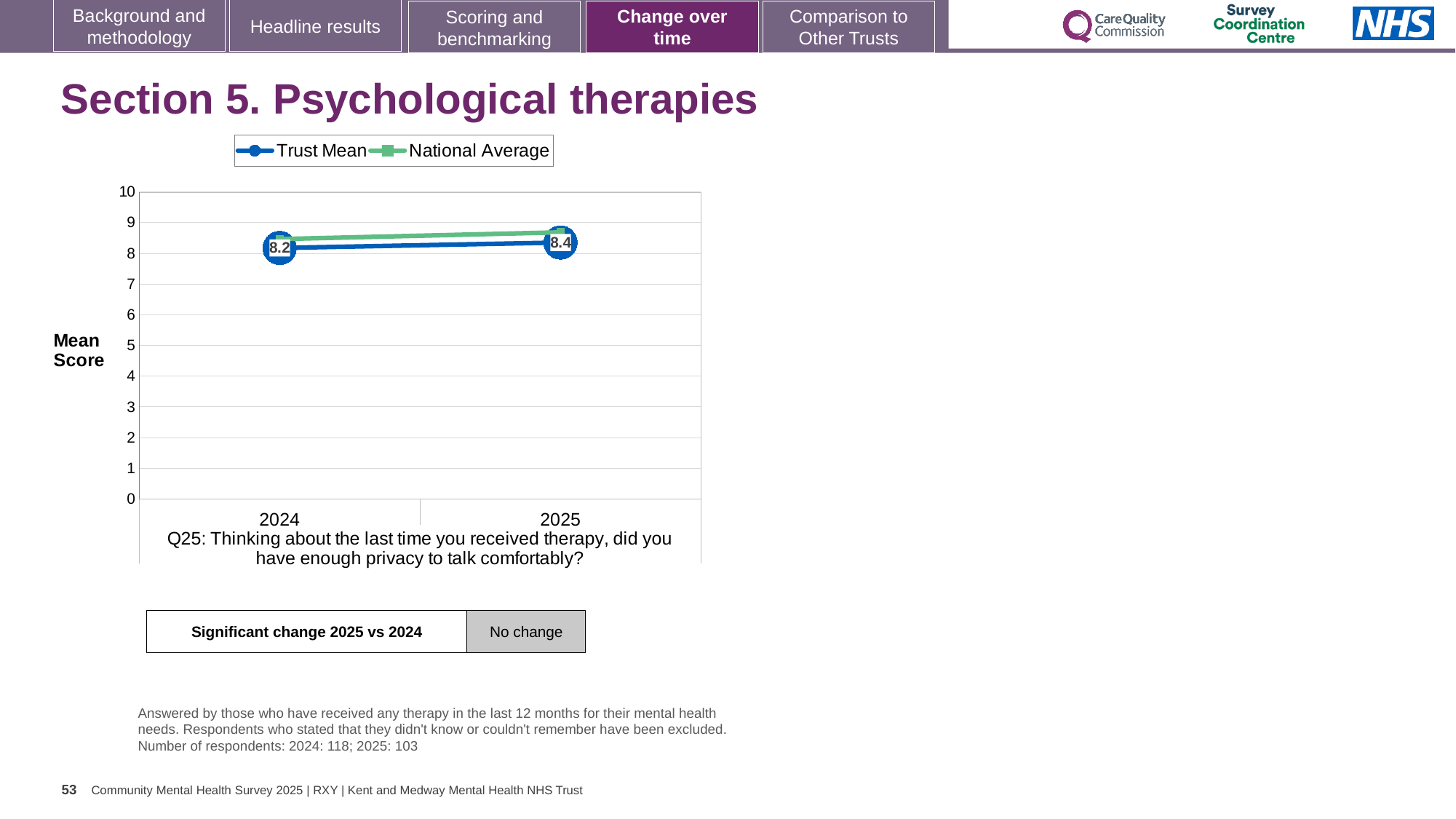
What kind of chart is shown on the slide? Line chart Is the National Average for 2025 greater or less than 9? less Does the Trust Mean rise or fall from 2024 to 2025? Rise In which year is the Trust Mean higher, 2024 or 2025? 2025 In 2024, which is larger, the Trust Mean or the National Average? National Average In which year is the Trust Mean lowest? 2024 What is the difference between the Trust Mean in 2025 and in 2024? 0.2 Is the National Average for 2024 greater or less than 8? greater What is the Trust Mean score for 2025? 8.4 How many series does the legend list? 2 What is the Trust Mean score for 2024? 8.2 How many years are plotted on the x axis? 2